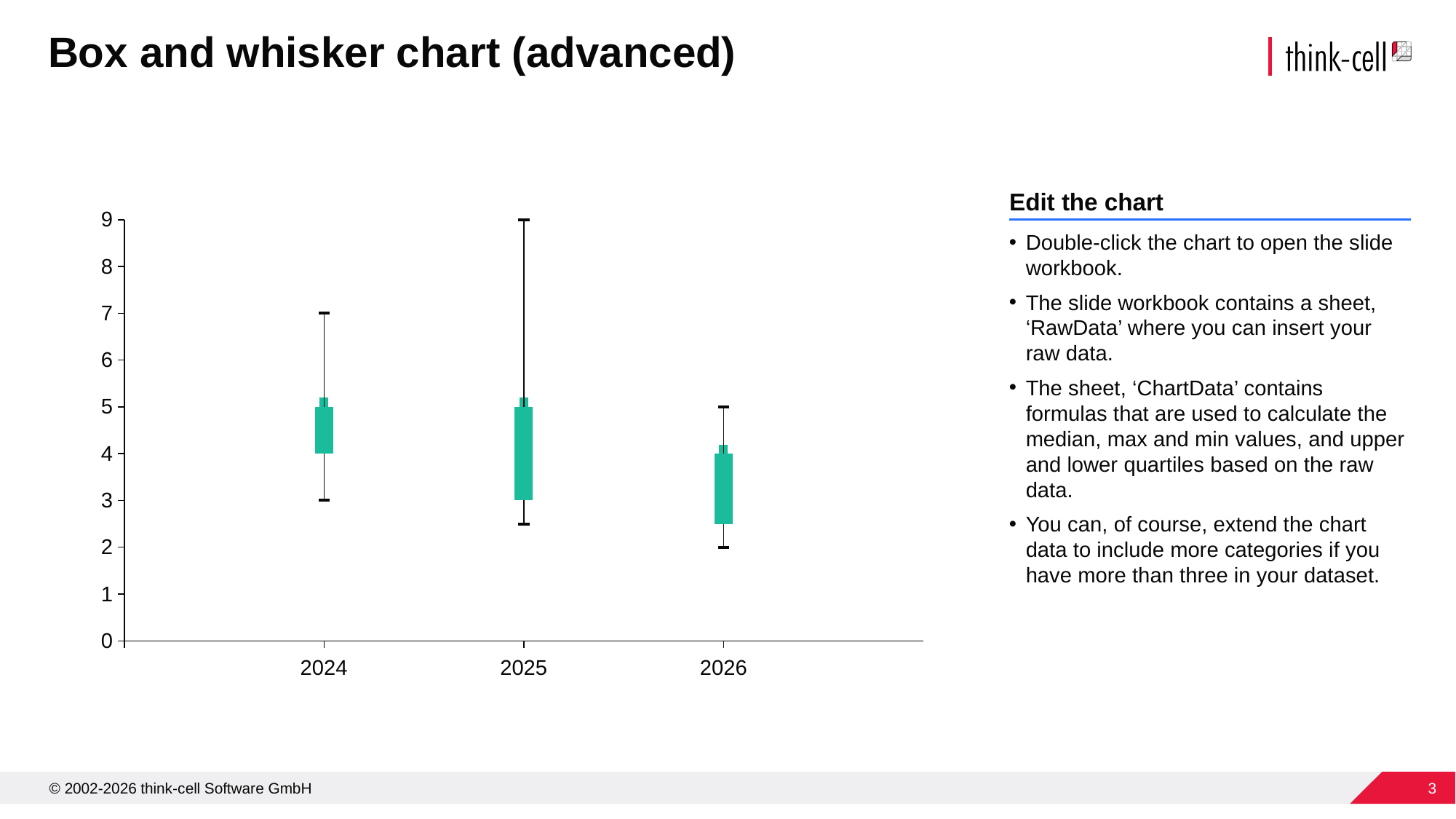
Which has a higher upper whisker, 2024 or 2026? 2024 What value does the lower whisker for 2024 reach? 3 Which category has the lowest lower whisker? 2026 How many categories are plotted on the x axis? 3 What kind of chart is shown on the slide? Box and whisker chart What is the title of the slide containing the chart? Box and whisker chart (advanced) What value does the lower whisker for 2026 reach? 2 Is the top of the box for 2026 greater or less than 5? less What value does the upper whisker for 2024 reach? 7 Which category has the highest upper whisker? 2025 What value does the upper whisker for 2026 reach? 5 What value does the upper whisker for 2025 reach? 9